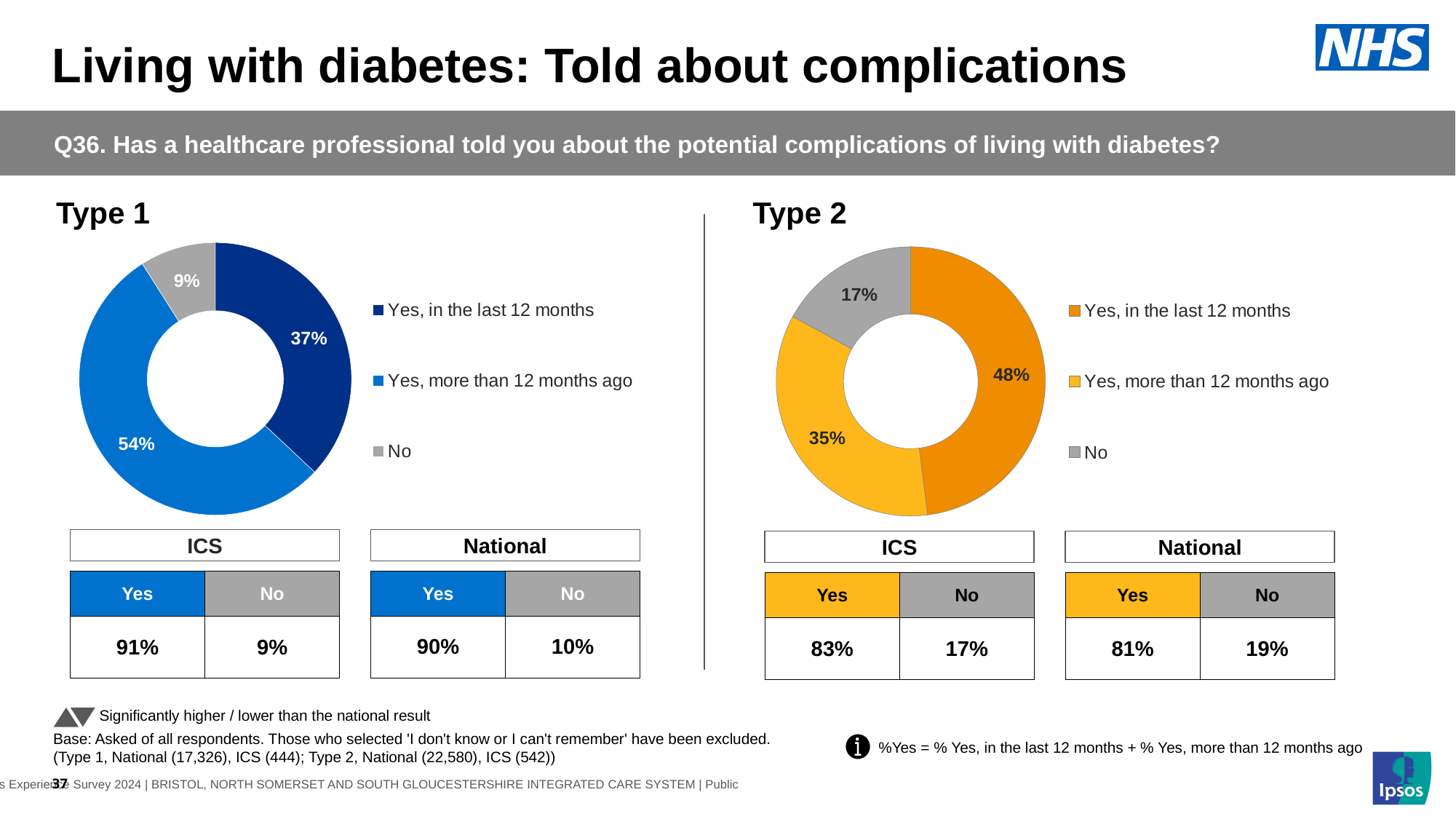
In the Type 1 chart, which response has the largest share? Yes, more than 12 months ago What colour represents 'No' in both the Type 1 and Type 2 charts? Grey In the Type 2 chart, what percentage of respondents said 'Yes, in the last 12 months'? 48% How many categories does the Type 2 chart show? 3 In the Type 1 chart, which is larger: 'Yes, in the last 12 months' or 'No'? Yes, in the last 12 months In the Type 1 chart, what is the combined share of the two 'Yes' responses? 91% In the Type 2 chart, what percentage of respondents said 'No'? 17% In the Type 2 chart, which response has the smallest share? No In the Type 2 chart, what is the difference between 'Yes, in the last 12 months' and 'Yes, more than 12 months ago'? 13 percentage points In the Type 1 chart, what percentage of respondents said 'Yes, more than 12 months ago'? 54% In the Type 1 chart, what percentage of respondents said 'Yes, in the last 12 months'? 37% What kind of chart is used for Type 1? Doughnut (pie) chart